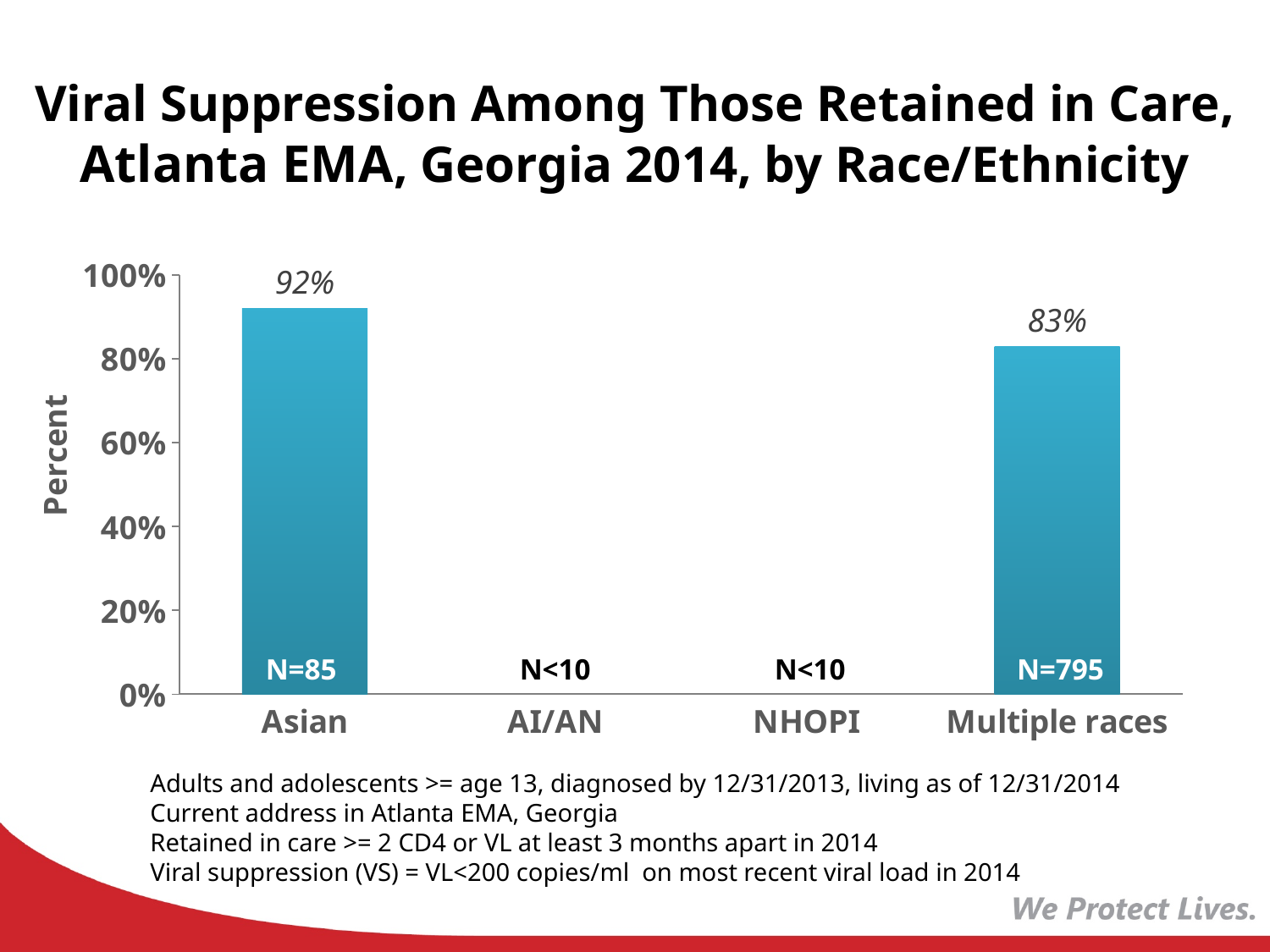
What is the viral suppression percentage for Multiple races? 83% What is the difference in viral suppression percentage between Asian and Multiple races? 9% Which has a higher viral suppression percentage, Asian or Multiple races? Asian What is the N value shown for the Asian category? N=85 Which race/ethnicity category has the highest viral suppression percentage shown? Asian What type of chart is shown on the slide? Bar chart Is the value for Asian greater or less than 90%? greater What is the viral suppression percentage for Asian? 92% What is the label on the y axis of the chart? Percent How many race/ethnicity categories are shown on the x axis? 4 What is the N value shown for the Multiple races category? N=795 Is the value for Multiple races greater or less than 80%? greater